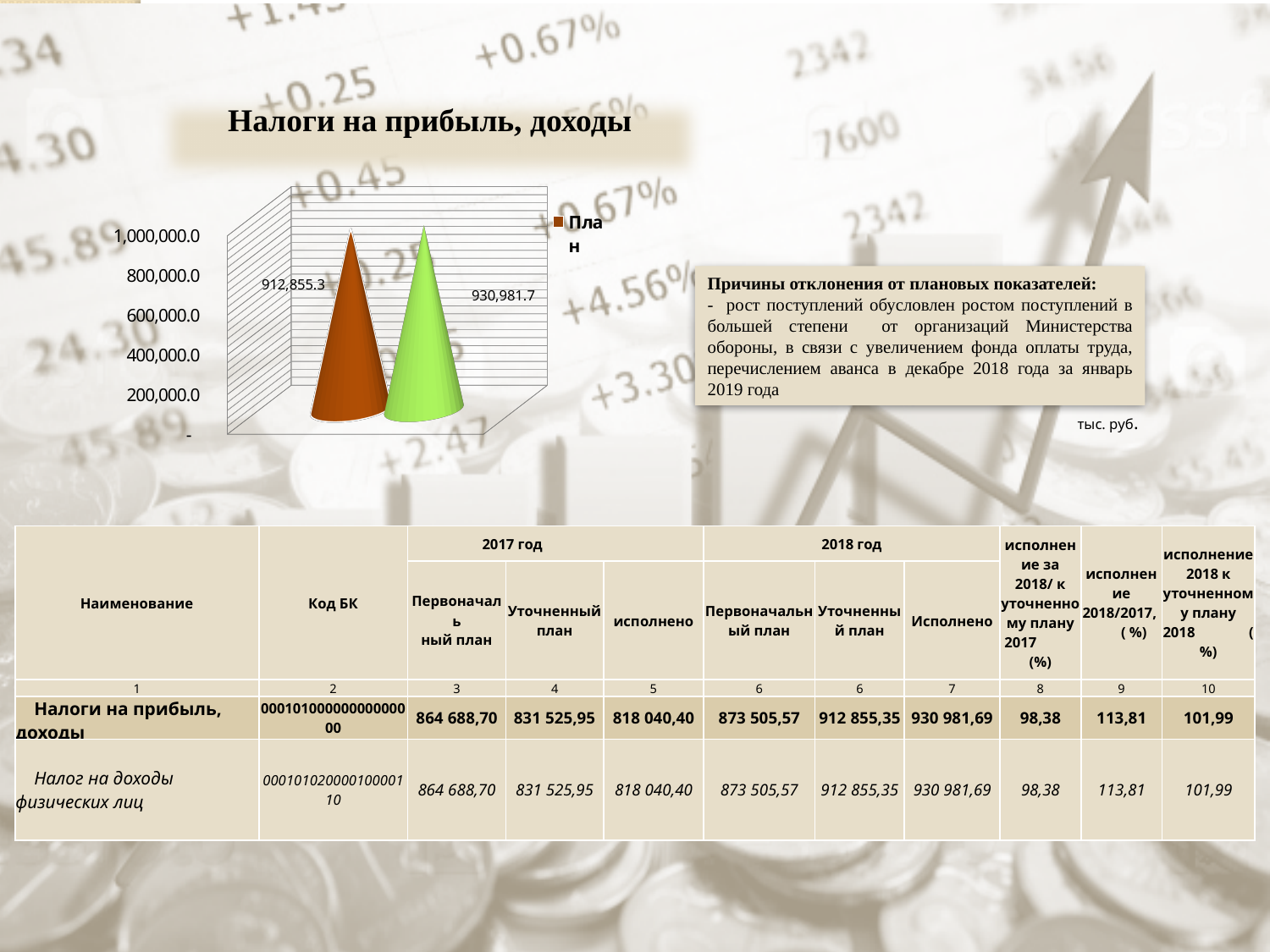
What is the value shown on the brown (left) cone in the chart? 912,855.3 Is the value of the brown cone in the chart greater or less than 800,000.0? greater What is the difference between the values of the green cone and the brown cone in the chart? 18,126.4 Which cone in the chart has the lower value, the brown one or the green one? the brown one Do the values in the chart rise or fall from the left cone to the right cone? rise What is the highest value labelled on the vertical axis of the chart? 1,000,000.0 How many cones (data points) are plotted in the chart? 2 Is the value of the green cone in the chart greater or less than 1,000,000.0? less Which cone in the chart has the higher value, the brown one or the green one? the green one What is the value shown on the green (right) cone in the chart? 930,981.7 Is the value of the brown cone (912,855.3) larger or smaller than the value of the green cone (930,981.7)? smaller What is the title of the slide above the chart? Налоги на прибыль, доходы